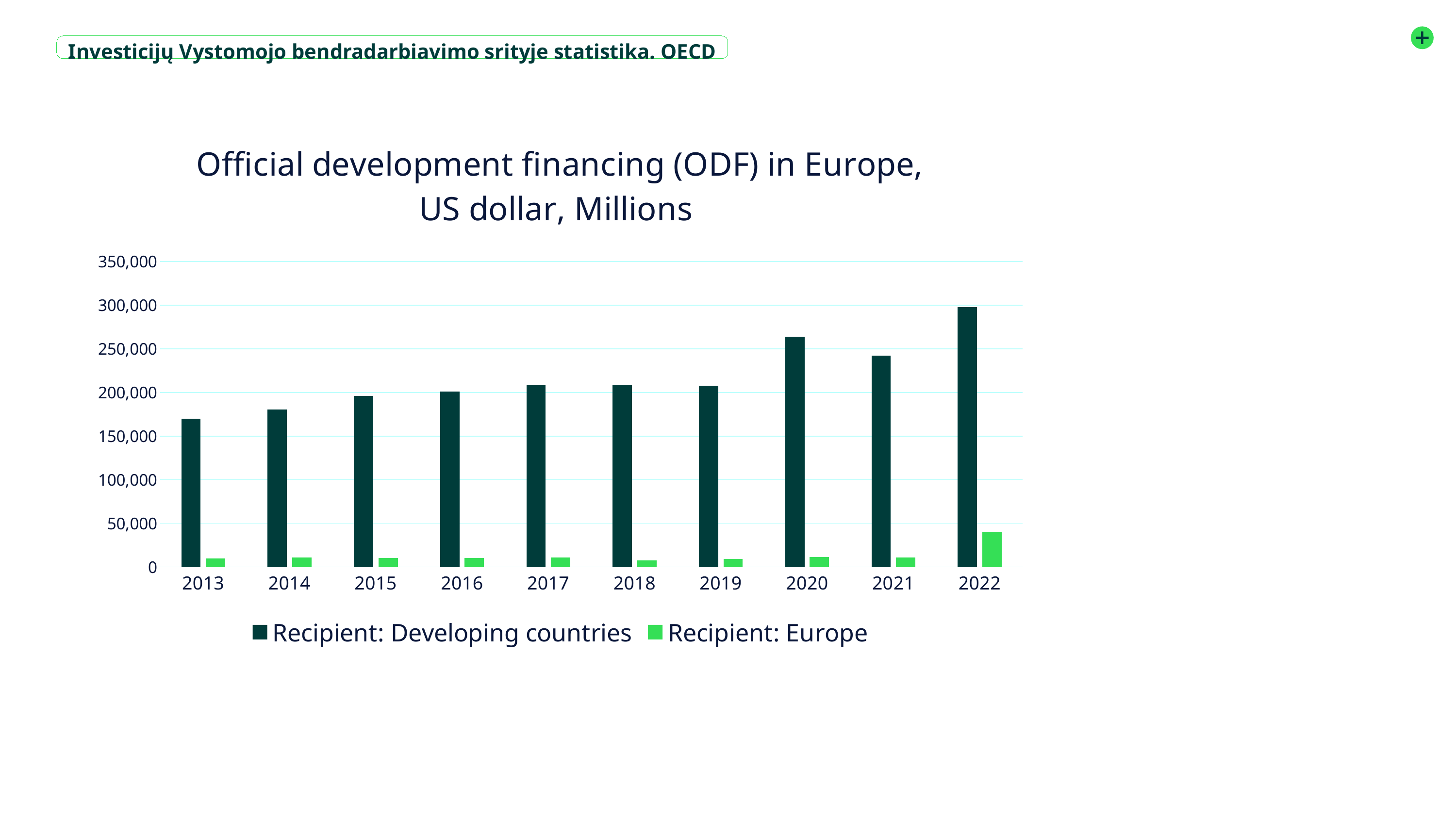
How many series does the legend list? 2 Which year has the lowest value for Recipient: Developing countries? 2013 Which year has the highest value for Recipient: Developing countries? 2022 Do the values for Recipient: Developing countries generally rise or fall from 2013 to 2022? rise Which year has the highest value for Recipient: Europe? 2022 Is the value for Recipient: Europe in 2022 greater or less than 50,000? less What is the title of the chart? Official development financing (ODF) in Europe, US dollar, Millions Is the value for Recipient: Developing countries in 2020 greater or less than 250,000? greater How many years are shown on the x axis? 10 Which is larger for Recipient: Developing countries, the value in 2020 or in 2021? 2020 What kind of chart is shown on the slide? bar chart Is the value for Recipient: Developing countries in 2013 greater or less than 200,000? less